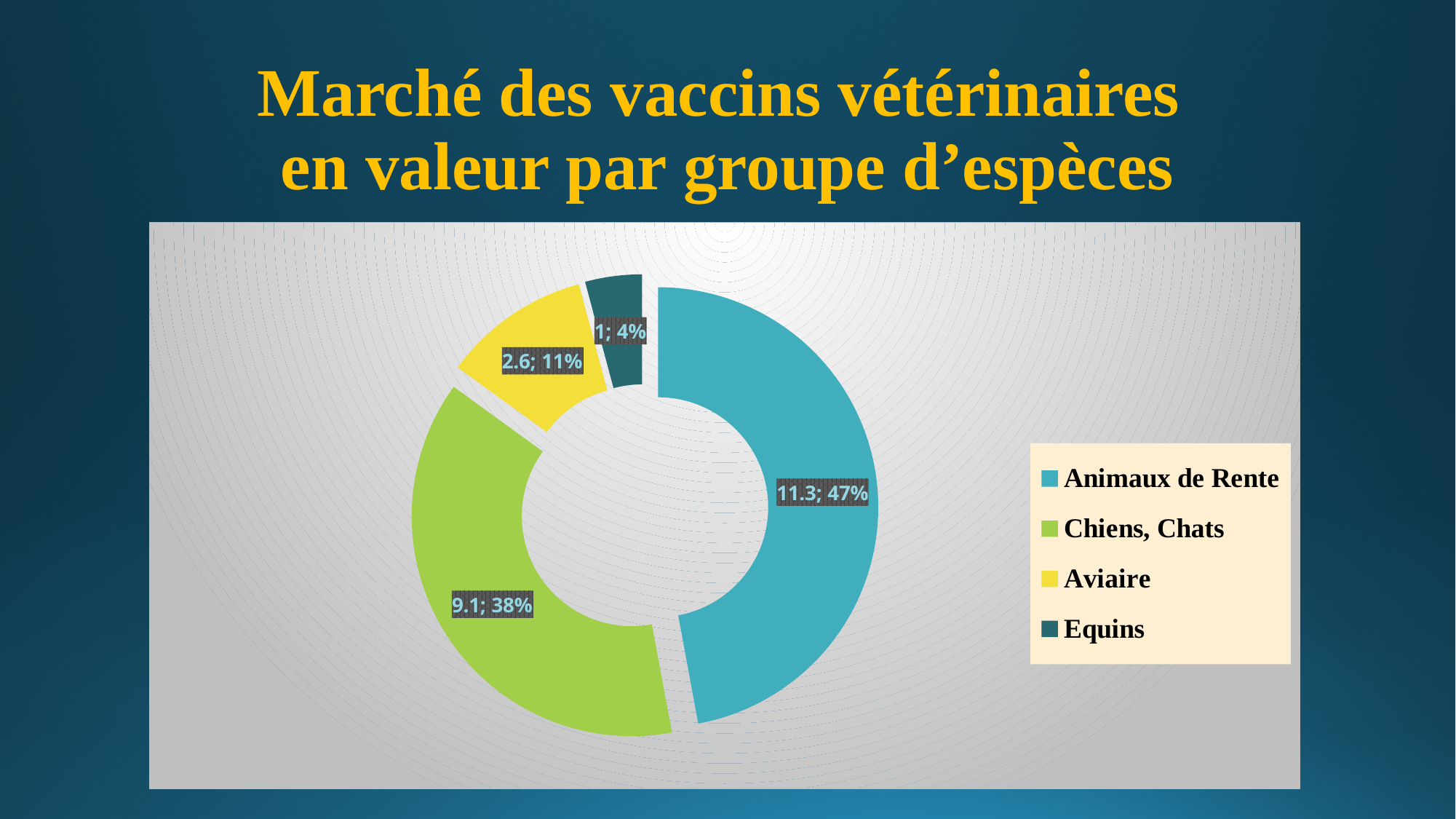
What share of the chart does Aviaire represent? 11% Which category has the smallest share? Equins What kind of chart is shown on the slide? Doughnut (pie) chart What share of the chart does Animaux de Rente represent? 47% Which is larger, the value for Aviaire or the value for Equins? Aviaire How many categories does the chart show? 4 What is the value shown for Aviaire? 2.6 What is the value shown for Chiens, Chats? 9.1 What is the difference between the values for Animaux de Rente and Chiens, Chats? 2.2 What is the value shown for Animaux de Rente? 11.3 What is the value shown for Equins? 1 Which category has the largest share? Animaux de Rente